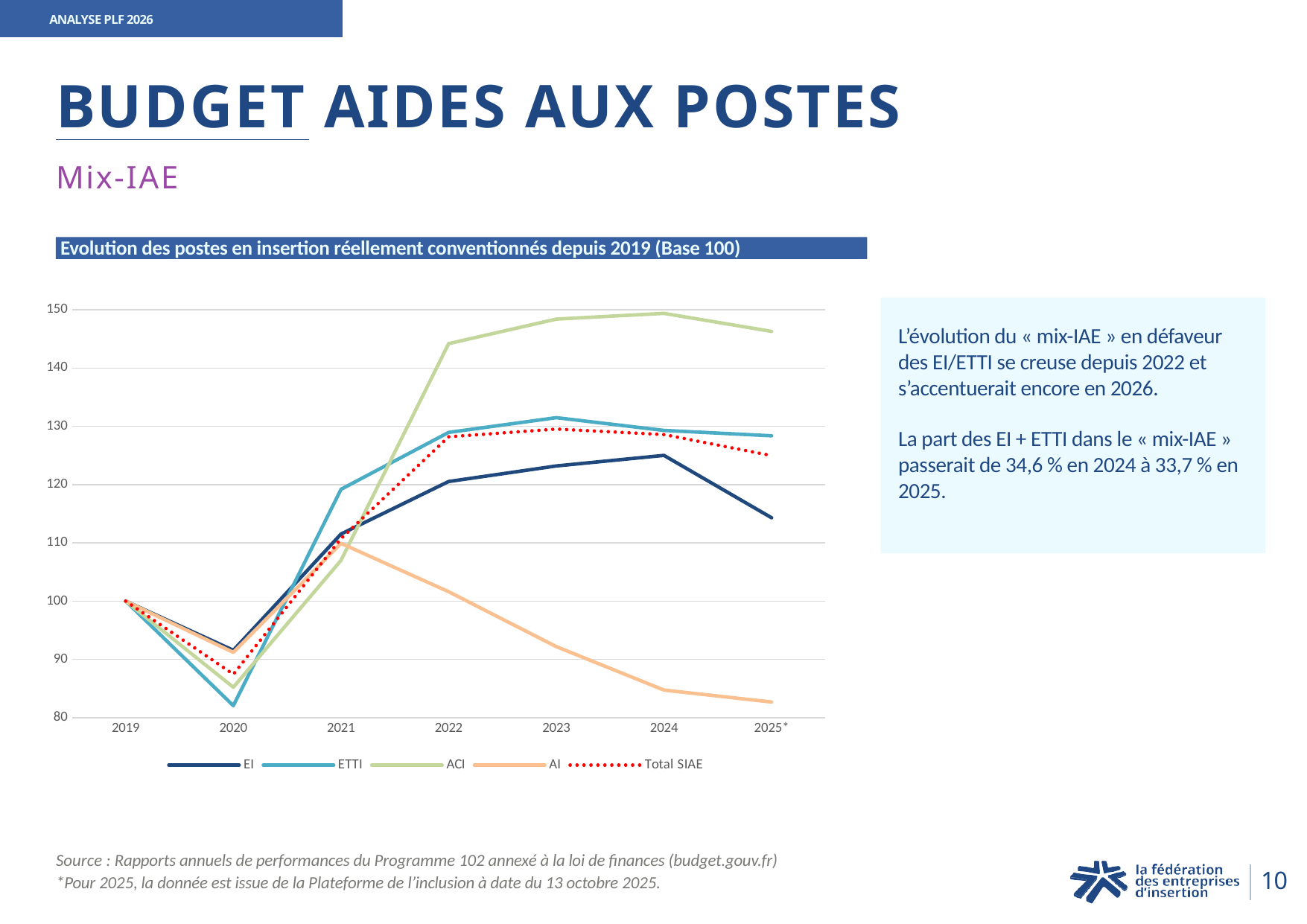
Which series has the highest value in 2025*? ACI What is the value of all series in 2019? 100 Is the value for AI in 2025* greater or less than 90? less Is the value for ACI in 2024 greater or less than 140? greater Does the AI series rise or fall between 2021 and 2025*? fall Is the value for EI in 2025* greater or less than 120? less How many series does the chart legend list? 5 Which is larger in 2023, the value for ACI or the value for EI? ACI Which series has the lowest value in 2025*? AI How many years are shown on the x axis of the chart? 7 What kind of chart is shown on the slide? line chart Which series has the lowest value in 2020? ETTI